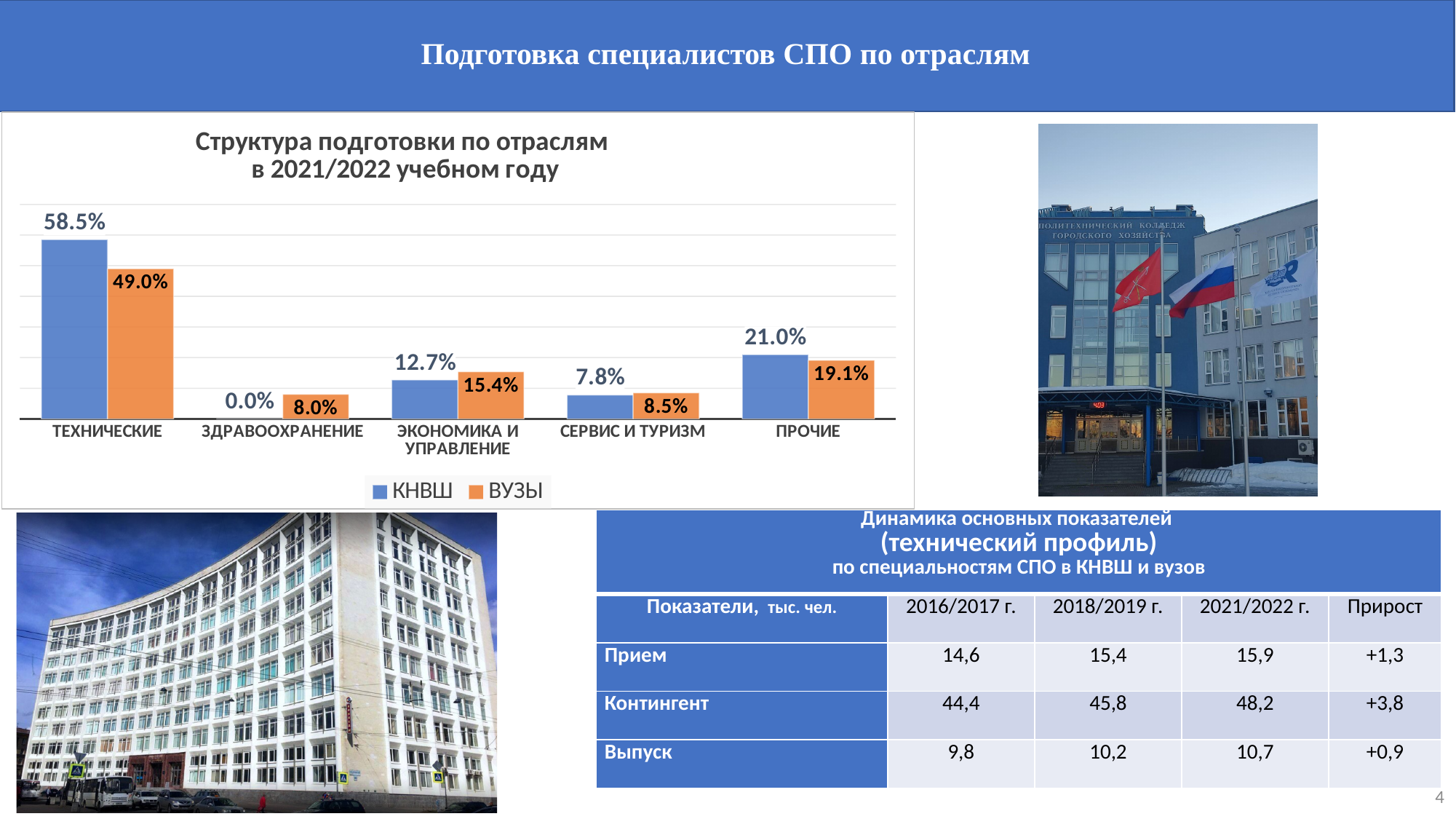
For ПРОЧИЕ, which series has the larger value, КНВШ or ВУЗЫ? КНВШ What is the КНВШ value for ТЕХНИЧЕСКИЕ? 58.5% Which category has the lowest КНВШ value? ЗДРАВООХРАНЕНИЕ What is the ВУЗЫ value for ЭКОНОМИКА И УПРАВЛЕНИЕ? 15.4% How many series does the chart legend list? 2 Which category has the highest ВУЗЫ value? ТЕХНИЧЕСКИЕ What type of chart is shown on the slide? Bar chart How many categories are shown on the x axis of the chart? 5 What is the КНВШ value for ЗДРАВООХРАНЕНИЕ? 0.0% What is the ВУЗЫ value for ПРОЧИЕ? 19.1% What is the difference between the ВУЗЫ and КНВШ values for ЭКОНОМИКА И УПРАВЛЕНИЕ? 2.7 percentage points What is the difference between the КНВШ and ВУЗЫ values for ТЕХНИЧЕСКИЕ? 9.5 percentage points